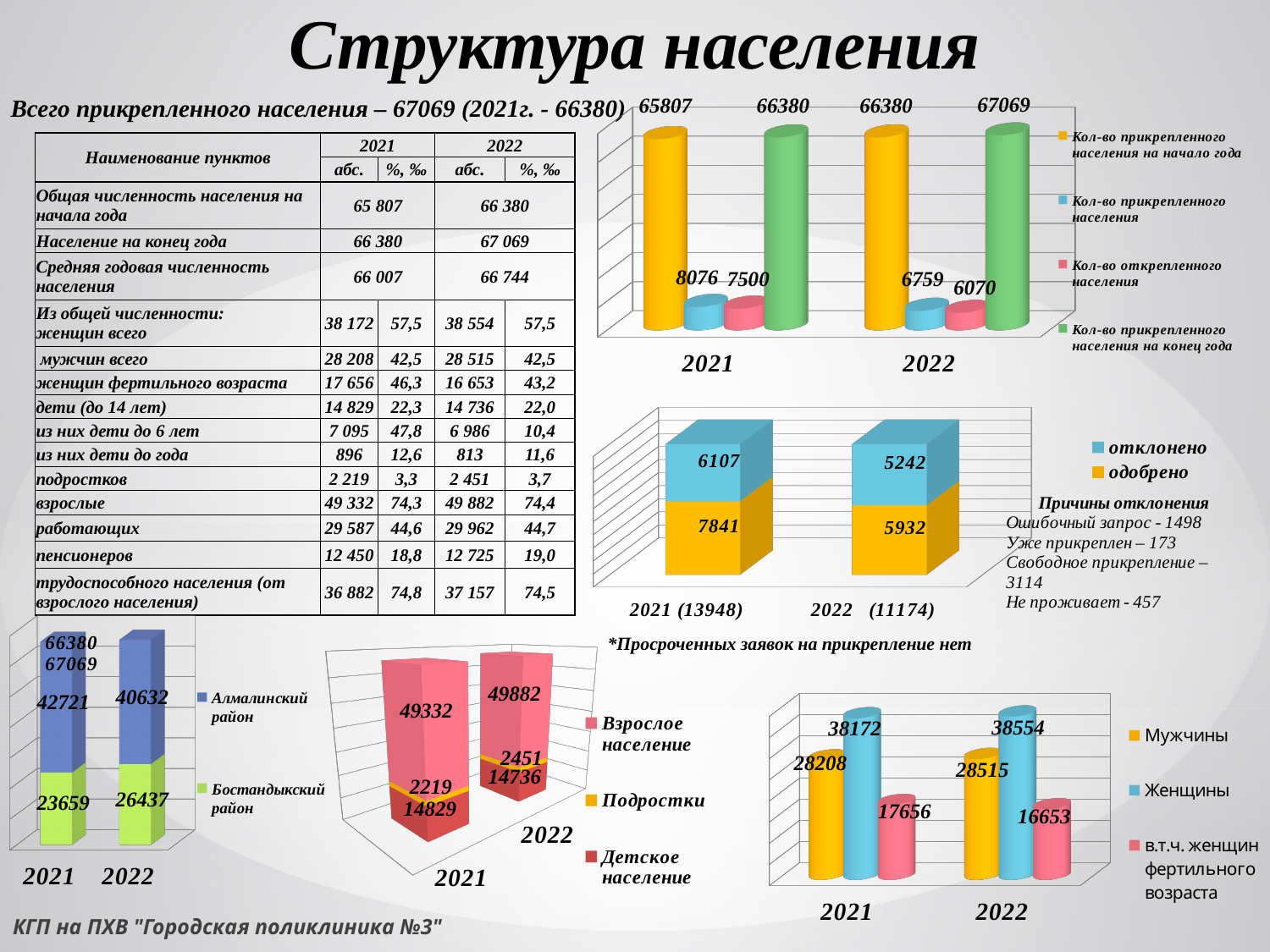
In the middle-right stacked chart (отклонено/одобрено), what is the total of the 2021 bar? 13948 In the middle-right stacked chart, what is the difference between the 'отклонено' values for 2021 and 2022? 865 In the top-right chart, what is the value for 'Кол-во прикрепленного населения на конец года' in 2022? 67069 In the bottom-middle chart, which category has the lowest value in 2021? Подростки In the bottom-left chart, which district has the larger value in 2021, Алмалинский район or Бостандыкский район? Алмалинский район In the top-right chart, what is the value for 'Кол-во открепленного населения' in 2021? 7500 In the bottom-right chart, what is the value for 'в.т.ч. женщин фертильного возраста' in 2022? 16653 In the bottom-left chart, what is the value for 'Бостандыкский район' in 2022? 26437 In the bottom-right chart, what is the difference between 'Женщины' and 'Мужчины' in 2021? 9964 In the middle-right stacked chart (отклонено/одобрено), what is the 'одобрено' value for 2022? 5932 How many series does the legend of the top-right chart list? 4 In the bottom-middle chart, what is the value for 'Подростки' in 2022? 2451